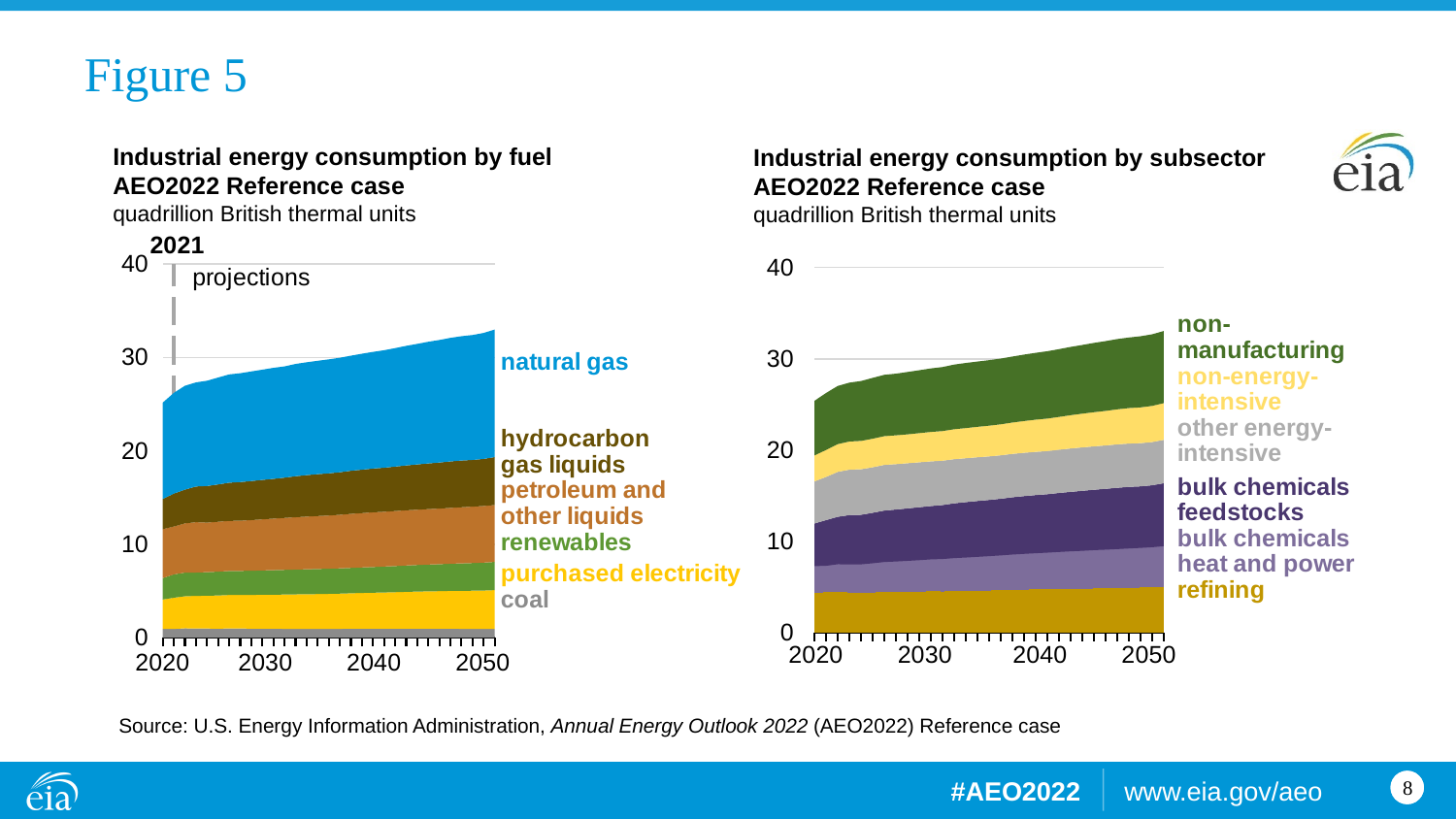
In the 'Industrial energy consumption by subsector' chart on the right, which subsector is at the bottom of the stack? refining In the 'Industrial energy consumption by fuel' chart on the left, is total industrial energy consumption in 2020 greater or less than 30 quadrillion British thermal units? less In the 'Industrial energy consumption by subsector' chart on the right, is total industrial energy consumption in 2050 greater or less than 30 quadrillion British thermal units? greater In the 'Industrial energy consumption by fuel' chart on the left, which fuel accounts for the smallest share of consumption? coal What unit is used on the y axis of both charts? quadrillion British thermal units In the 'Industrial energy consumption by subsector' chart on the right, does total industrial energy consumption rise or fall from 2020 to 2050? rise How many subsector series are shown in the 'Industrial energy consumption by subsector' chart on the right? 6 In the 'Industrial energy consumption by fuel' chart on the left, which fuel accounts for the largest share of consumption? natural gas What type of chart is the 'Industrial energy consumption by fuel' chart on the left? stacked area chart In the 'Industrial energy consumption by fuel' chart on the left, which year is marked as the start of the projections? 2021 In the 'Industrial energy consumption by fuel' chart on the left, is total industrial energy consumption in 2050 greater or less than 30 quadrillion British thermal units? greater How many fuel series are shown in the 'Industrial energy consumption by fuel' chart on the left? 6